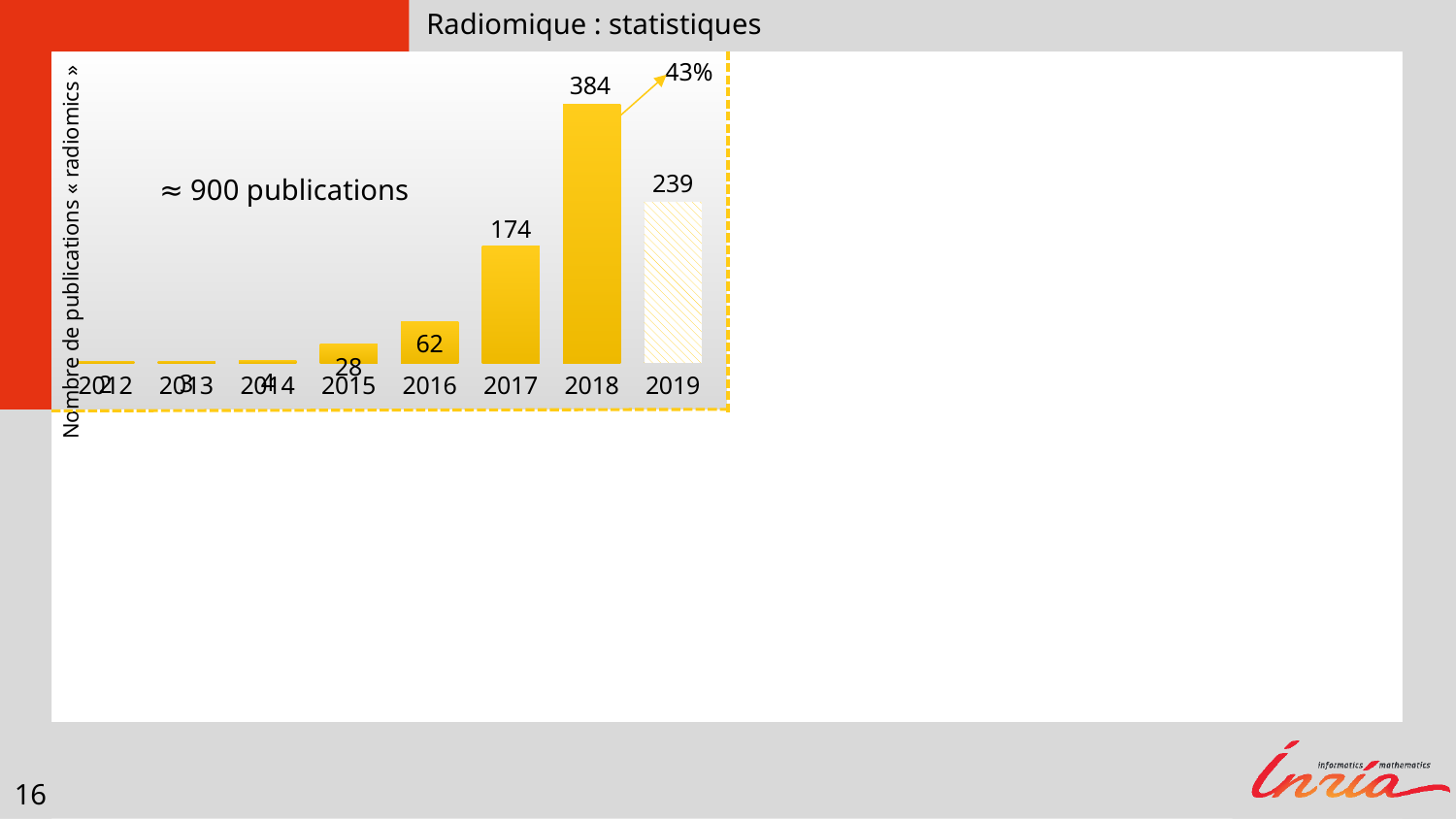
What is the value for 2017? 174 What is the value for 2018? 384 What is the difference between the values for 2017 and 2016? 112 Which is larger, the value for 2019 or the value for 2017? 2019 What is the value for 2015? 28 How many years are shown on the x axis? 8 What is the value for 2019? 239 What is the value for 2016? 62 Do the values rise or fall from 2015 to 2018? Rise What is the difference between the values for 2018 and 2017? 210 What kind of chart is shown on the slide? Bar chart Which year has the highest value? 2018